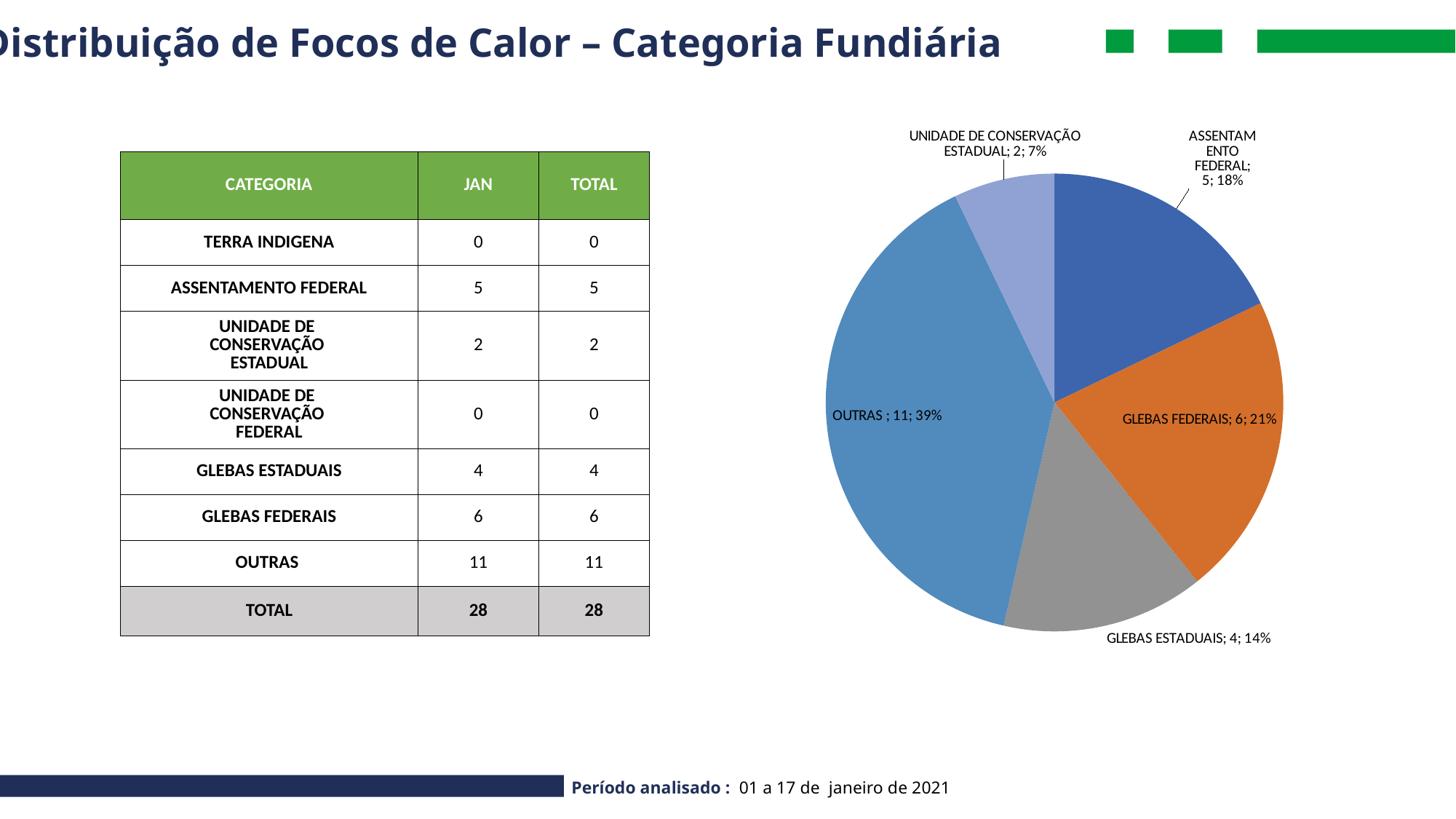
What share of the pie does GLEBAS FEDERAIS represent? 21% How many slices does the pie chart have? 5 Which is larger in the pie chart, GLEBAS FEDERAIS or ASSENTAMENTO FEDERAL? GLEBAS FEDERAIS What kind of chart is shown on the slide? pie chart What is the total of all slices in the pie chart? 28 What is the value for ASSENTAMENTO FEDERAL in the pie chart? 5 What share of the pie does UNIDADE DE CONSERVAÇÃO ESTADUAL represent? 7% What colour is the OUTRAS slice in the pie chart? blue What is the difference between the values for OUTRAS and GLEBAS ESTADUAIS in the pie chart? 7 Which category has the largest slice in the pie chart? OUTRAS Which category has the smallest slice in the pie chart? UNIDADE DE CONSERVAÇÃO ESTADUAL What is the value for OUTRAS in the pie chart? 11